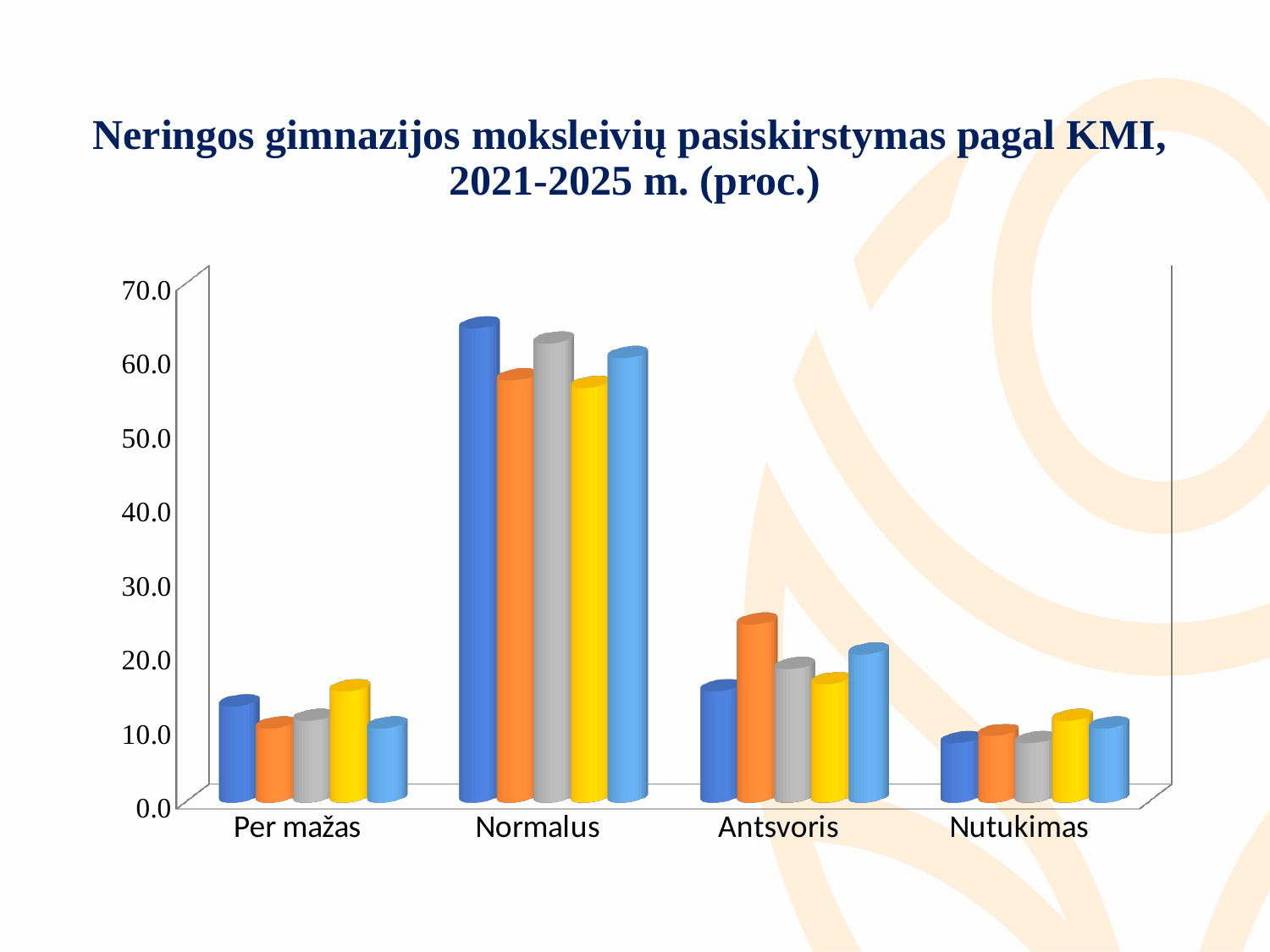
What is the title of the chart? Neringos gimnazijos moksleivių pasiskirstymas pagal KMI, 2021-2025 m. (proc.) Is the value of the second (orange) bar for Antsvoris greater or less than 20.0? greater Is the value of the second (orange) bar for Normalus greater or less than 60.0? less Is the value of the first (blue) bar for Normalus greater or less than 60.0? greater Which is larger: the first (blue) bar for Normalus or the first (blue) bar for Antsvoris? Normalus How many bars are plotted for each category? 5 Which category has the highest values? Normalus How many categories are shown on the x axis? 4 Which category has the lowest values? Nutukimas What kind of chart is shown on the slide? bar chart